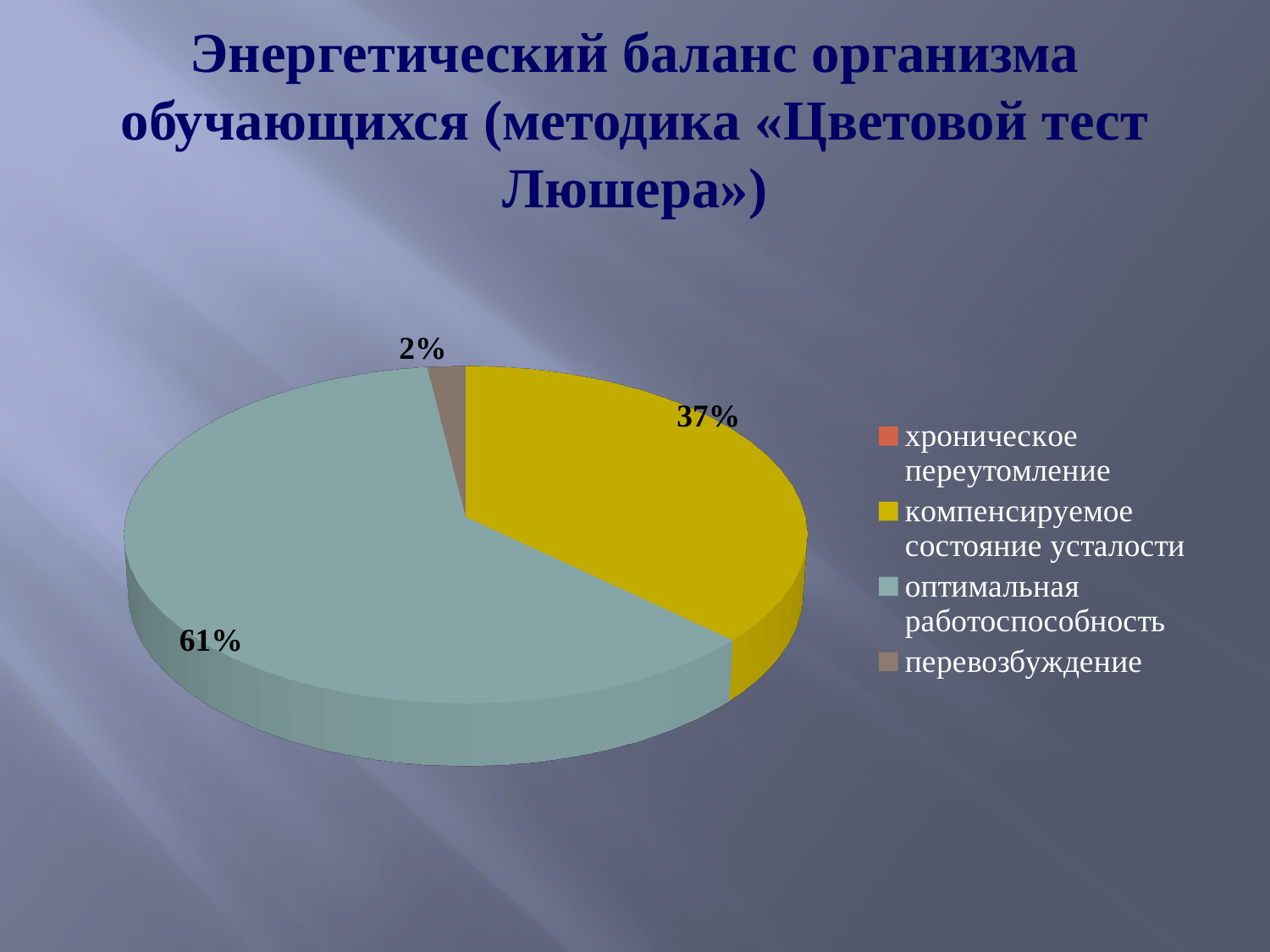
What is the difference in percentage points between the «компенсируемое состояние усталости» slice and the «перевозбуждение» slice? 35 percentage points Which legend entry is shown with a red-orange colour marker? хроническое переутомление What kind of chart is shown on the slide? pie chart What share of the pie is labeled for «перевозбуждение»? 2% What share of the pie is labeled for «оптимальная работоспособность»? 61% What share of the pie is labeled for «компенсируемое состояние усталости»? 37% Which is larger: the slice for «компенсируемое состояние усталости» or the slice for «оптимальная работоспособность»? оптимальная работоспособность What colour is the slice for «компенсируемое состояние усталости»? yellow What is the difference in percentage points between the «оптимальная работоспособность» slice and the «компенсируемое состояние усталости» slice? 24 percentage points Which category has the largest slice of the pie? оптимальная работоспособность How many categories does the legend list? 4 How many slices of the pie have a percentage label? 3